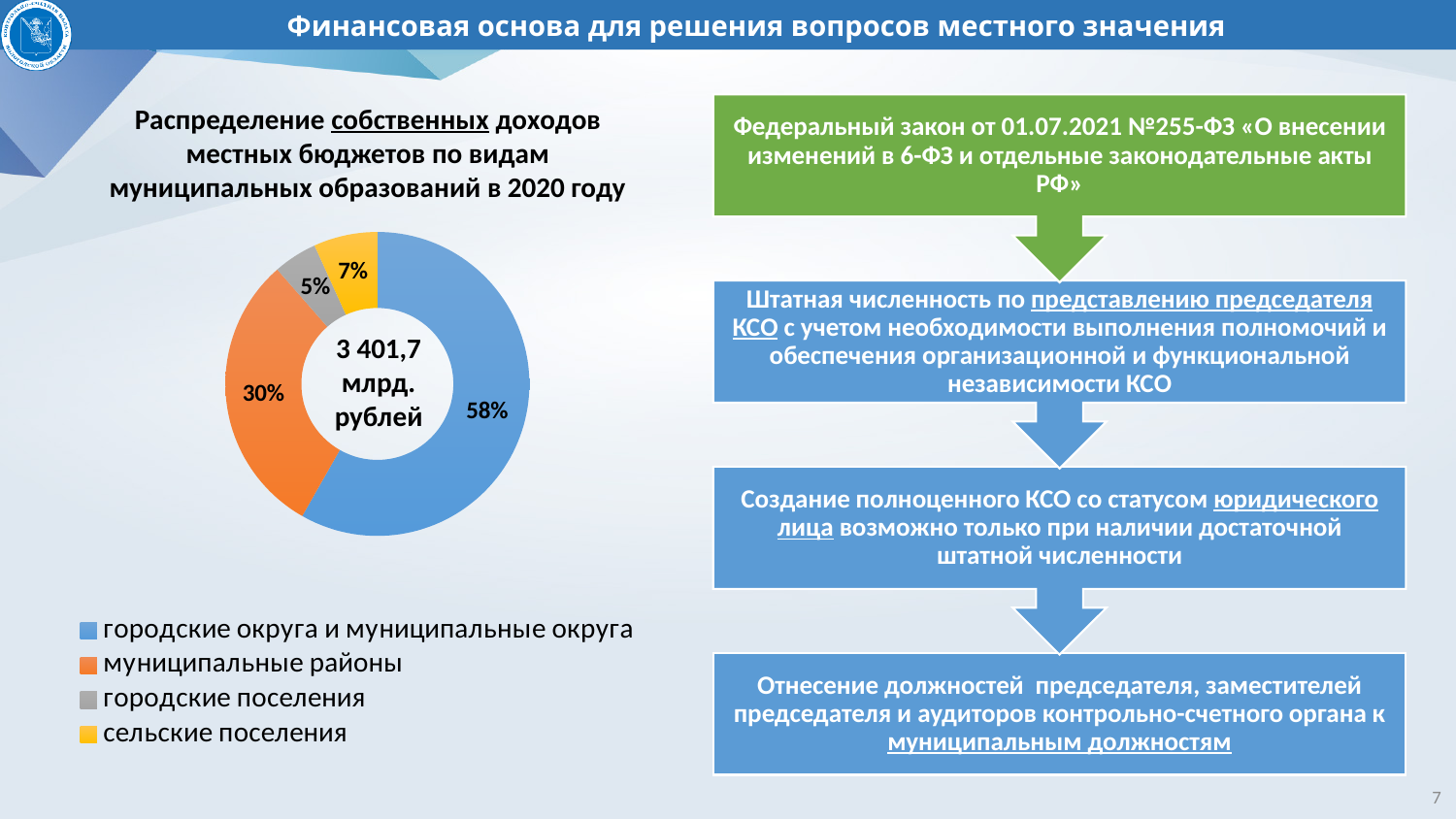
How many categories does the donut chart show? 4 What share of the donut chart is for городские округа и муниципальные округа? 58% What share of the donut chart is for муниципальные районы? 30% What is the difference in percentage points between the shares of городские округа и муниципальные округа and муниципальные районы? 28 Which category has the largest share in the donut chart? городские округа и муниципальные округа What share of the donut chart is for городские поселения? 5% What total value is printed in the centre of the donut chart? 3 401,7 млрд. рублей Which category has the smallest share in the donut chart? городские поселения What share of the donut chart is for сельские поселения? 7% Which colour represents муниципальные районы in the chart legend? orange What kind of chart is shown on the slide? donut (pie) chart Which has a larger share: сельские поселения or городские поселения? сельские поселения